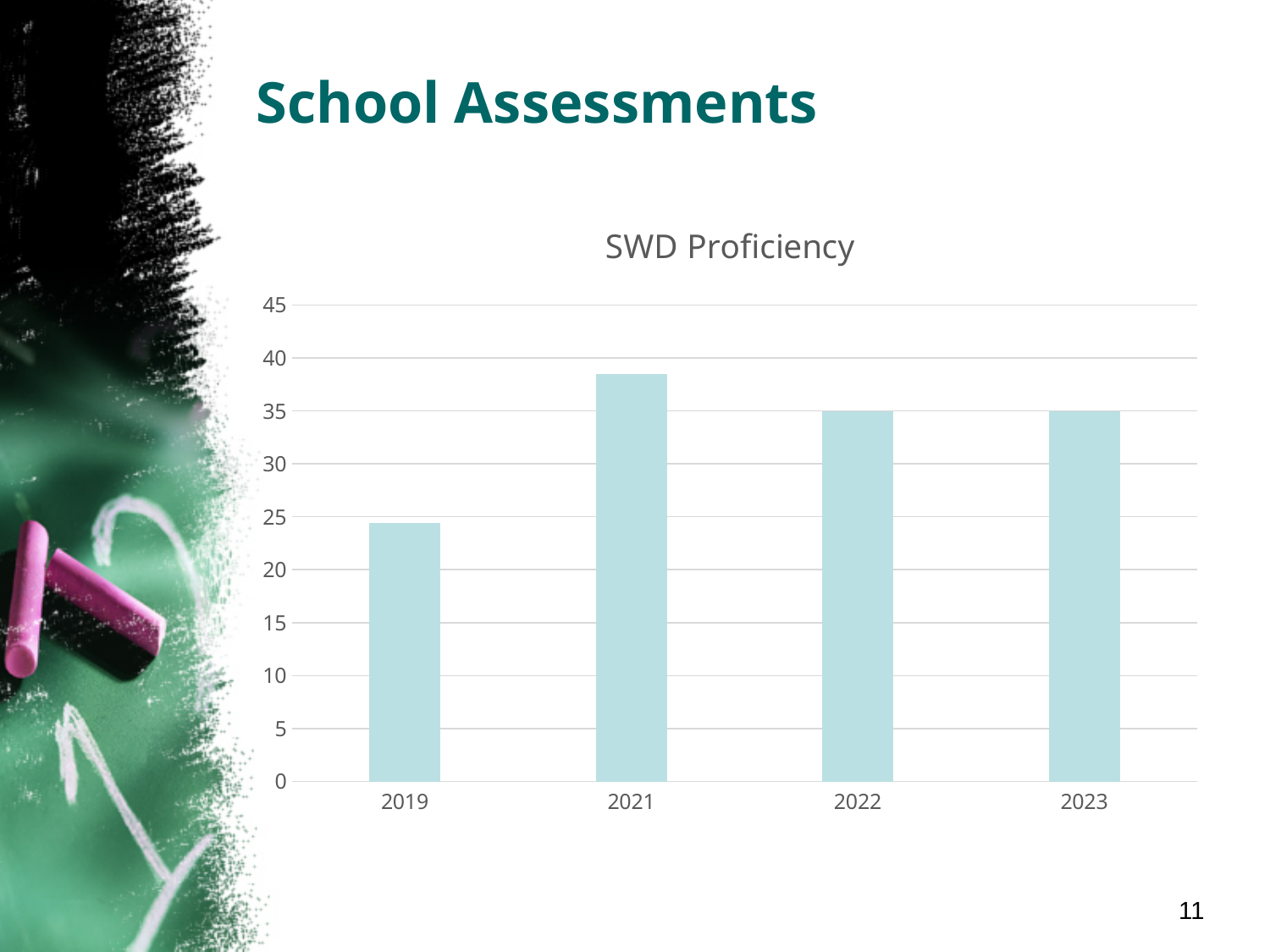
Is the value for 2021 greater or less than 35? greater Which year has the lowest SWD Proficiency value? 2019 Which year has the highest SWD Proficiency value? 2021 What kind of chart is shown on the slide? bar chart What is the SWD Proficiency value for 2023? 35 Is the value for 2019 greater or less than 25? less What is the SWD Proficiency value for 2022? 35 Which is larger, the value for 2019 or the value for 2021? 2021 Does the SWD Proficiency value rise or fall from 2019 to 2021? rise Is the value for 2019 greater or less than 20? greater How many years are shown on the x axis of the chart? 4 What is the title of the chart? SWD Proficiency